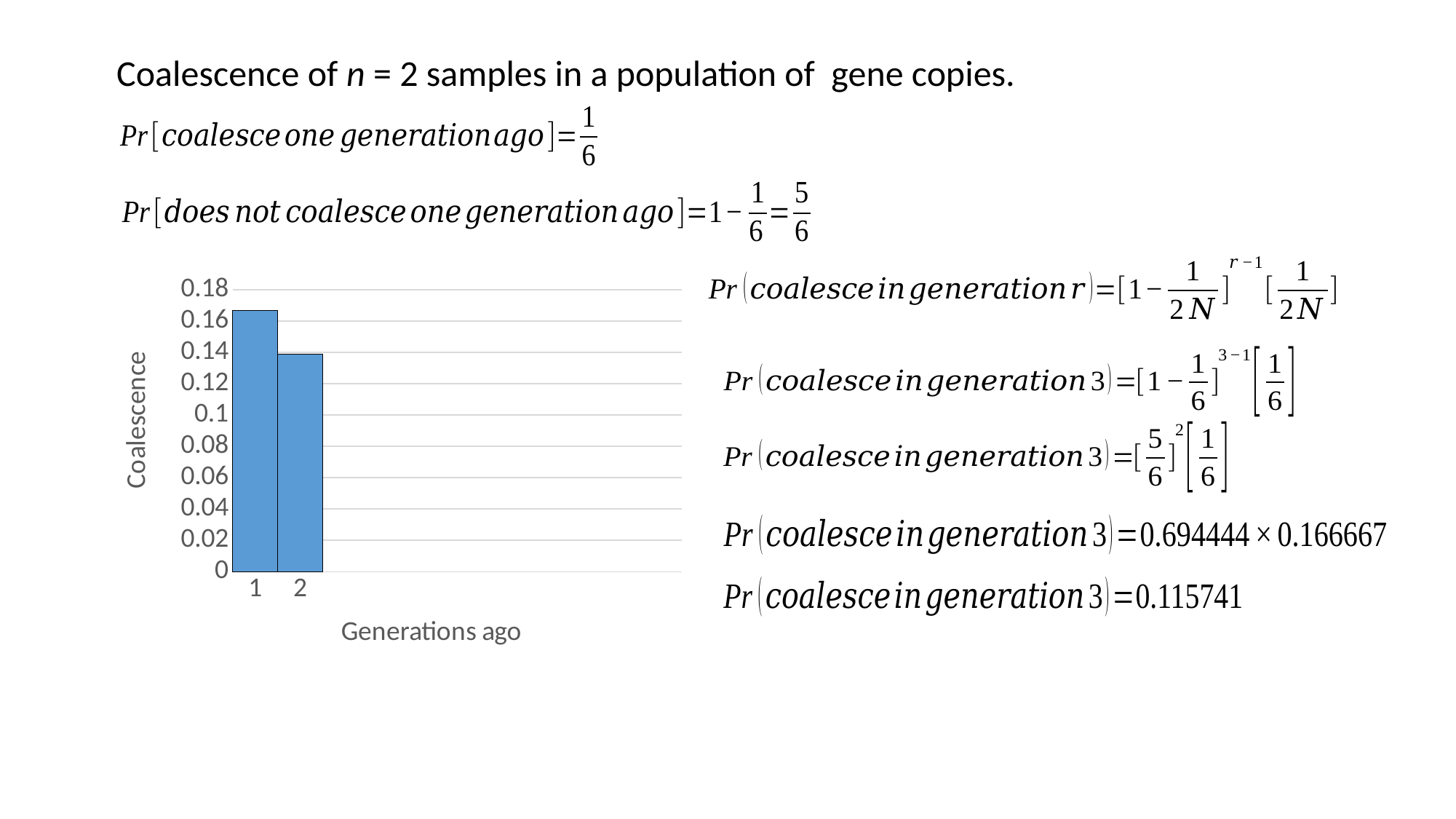
What is the title of the chart's x axis? Generations ago Is the coalescence value for 2 generations ago greater or less than 0.12? greater How many bars (categories) does the chart show? 2 What is the title of the chart's y axis? Coalescence Do the coalescence values rise or fall as generations ago increases from 1 to 2? fall Which bar is taller, the one for 1 generation ago or the one for 2 generations ago? 1 generation ago Is the coalescence value for 2 generations ago greater or less than 0.16? less Which generation ago has the highest coalescence value in the chart? 1 What kind of chart is shown on the slide? bar chart Which generation ago has the lowest coalescence value in the chart? 2 Is the coalescence value for 1 generation ago greater or less than 0.16? greater